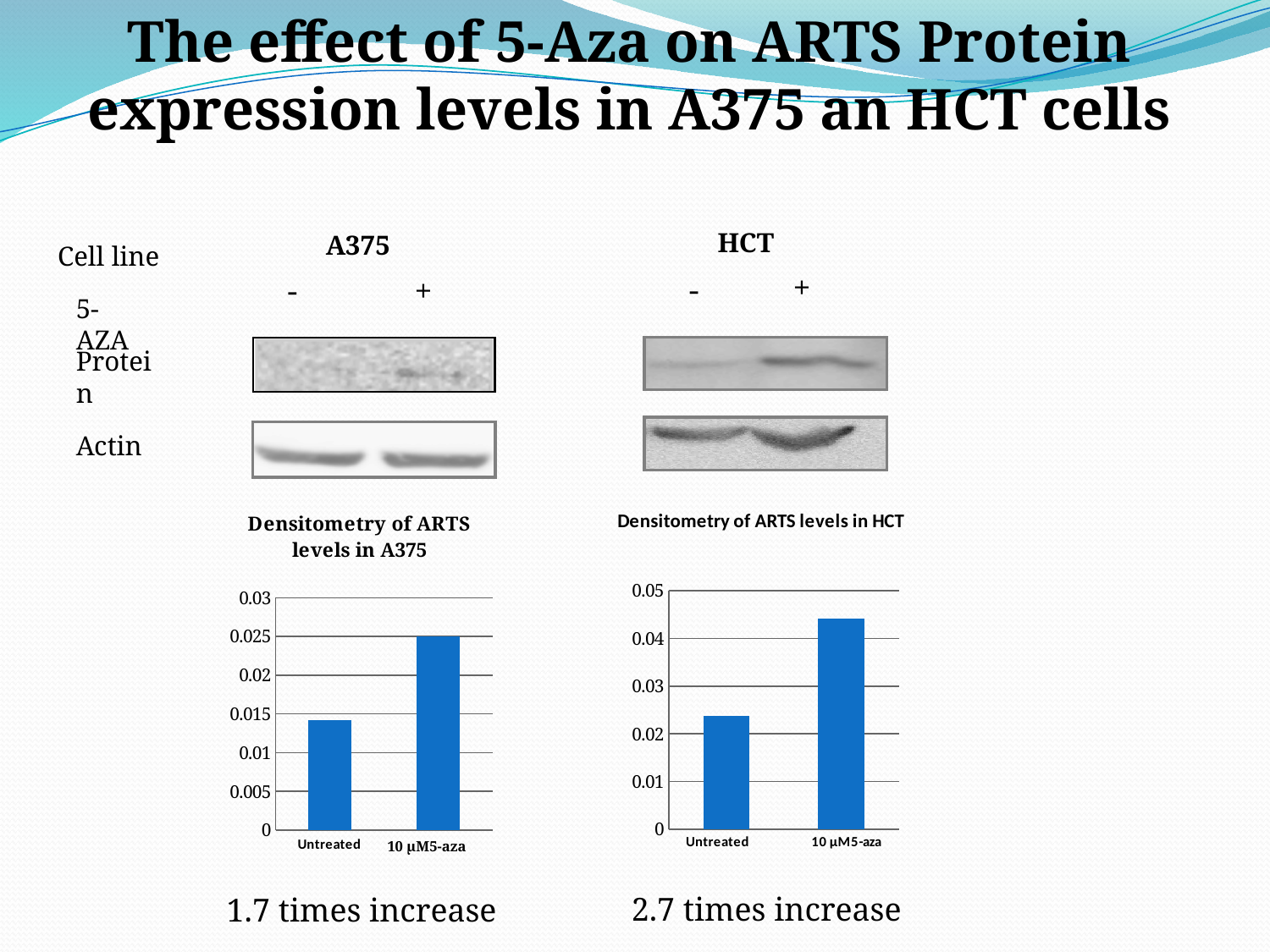
In the 'Densitometry of ARTS levels in HCT' chart, is the value for 10 µM5-aza greater or less than 0.04? greater In the 'Densitometry of ARTS levels in HCT' chart, is the value for Untreated greater or less than 0.03? less In the 'Densitometry of ARTS levels in A375' chart, is the value for 10 µM5-aza greater or less than 0.02? greater In the 'Densitometry of ARTS levels in A375' chart, which category has the highest value? 10 µM5-aza What is the maximum value shown on the y axis of the 'Densitometry of ARTS levels in HCT' chart? 0.05 What type of chart is the 'Densitometry of ARTS levels in A375' chart? bar chart How many categories are shown on the x axis of the 'Densitometry of ARTS levels in HCT' chart? 2 In the 'Densitometry of ARTS levels in HCT' chart, which is larger, the value for Untreated or for 10 µM5-aza? 10 µM5-aza What is the title of the bar chart on the left side of the slide? Densitometry of ARTS levels in A375 In the 'Densitometry of ARTS levels in HCT' chart, which category has the lowest value? Untreated In the 'Densitometry of ARTS levels in A375' chart, do the values rise or fall from Untreated to 10 µM5-aza? rise